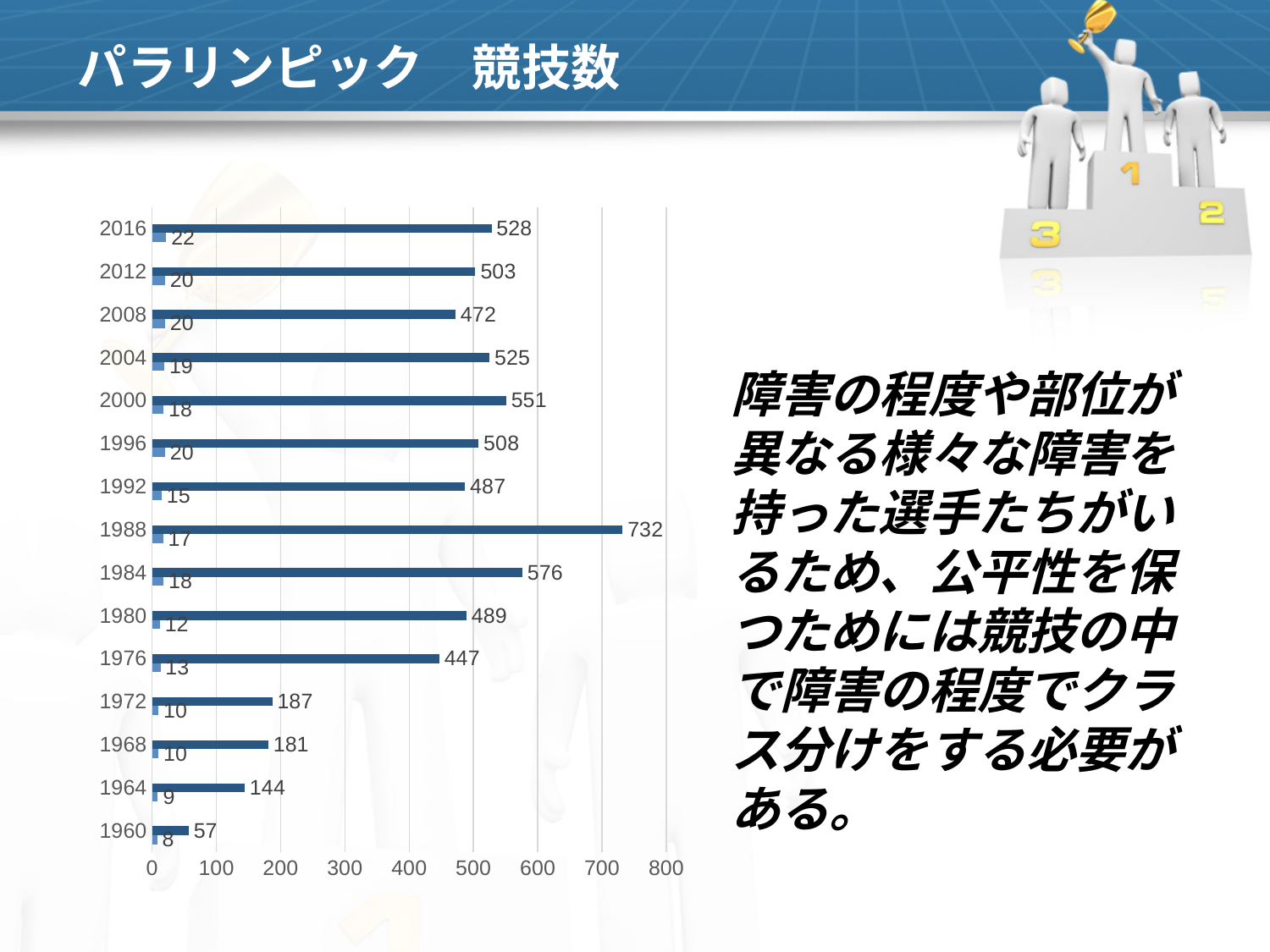
How many years (categories) are shown on the chart's vertical axis? 15 What is the value of the shorter light blue bar for 1960? 8 Which year has the highest value among the longer dark blue bars? 1988 What is the value of the longer dark blue bar for 1988? 732 What is the value of the longer dark blue bar for 2016? 528 What is the difference between the dark blue bar values for 1988 and 1984? 156 What is the value of the shorter light blue bar for 2016? 22 Which year has the larger dark blue bar value, 2000 or 2004? 2000 What is the title of the slide containing the chart? パラリンピック 競技数 Is the dark blue bar value for 1976 greater or less than 400? greater Which year has the lowest value among the longer dark blue bars? 1960 What type of chart is shown on the slide? bar chart